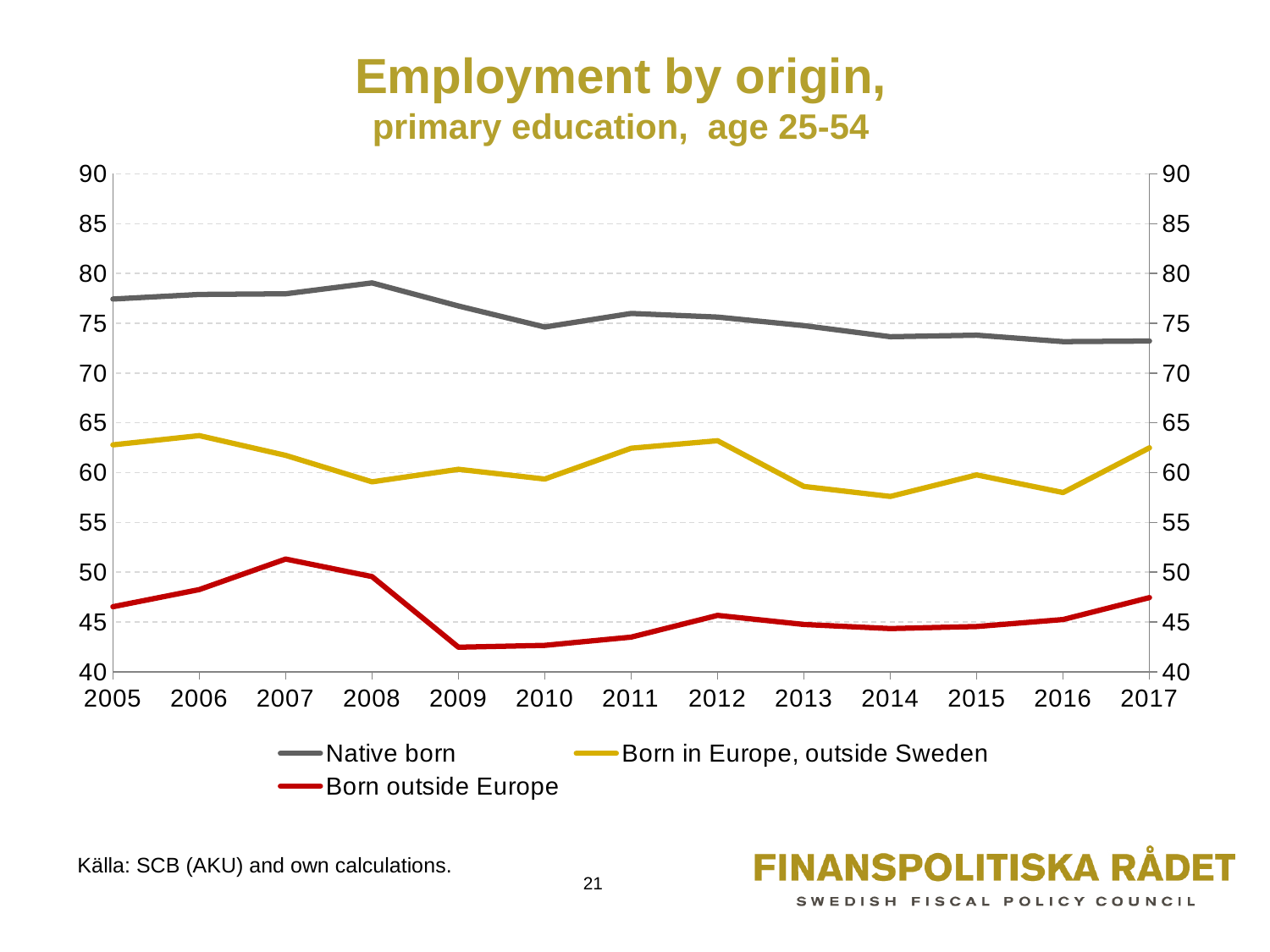
What colour is the line for Born outside Europe? Red Which series has the higher value in 2017, Native born or Born in Europe, outside Sweden? Native born How many years are plotted along the x axis? 13 Is the value for Born in Europe, outside Sweden in 2014 greater or less than 60? less What kind of chart is shown on the slide? Line chart Is the value for Born outside Europe in 2007 greater or less than 50? greater In which year does the Native born series reach its highest value? 2008 How many series does the legend list? 3 Does the Native born series rise or fall overall from 2005 to 2017? Fall Is the value for Native born in 2008 greater or less than 75? greater In which year does the Born outside Europe series reach its highest value? 2007